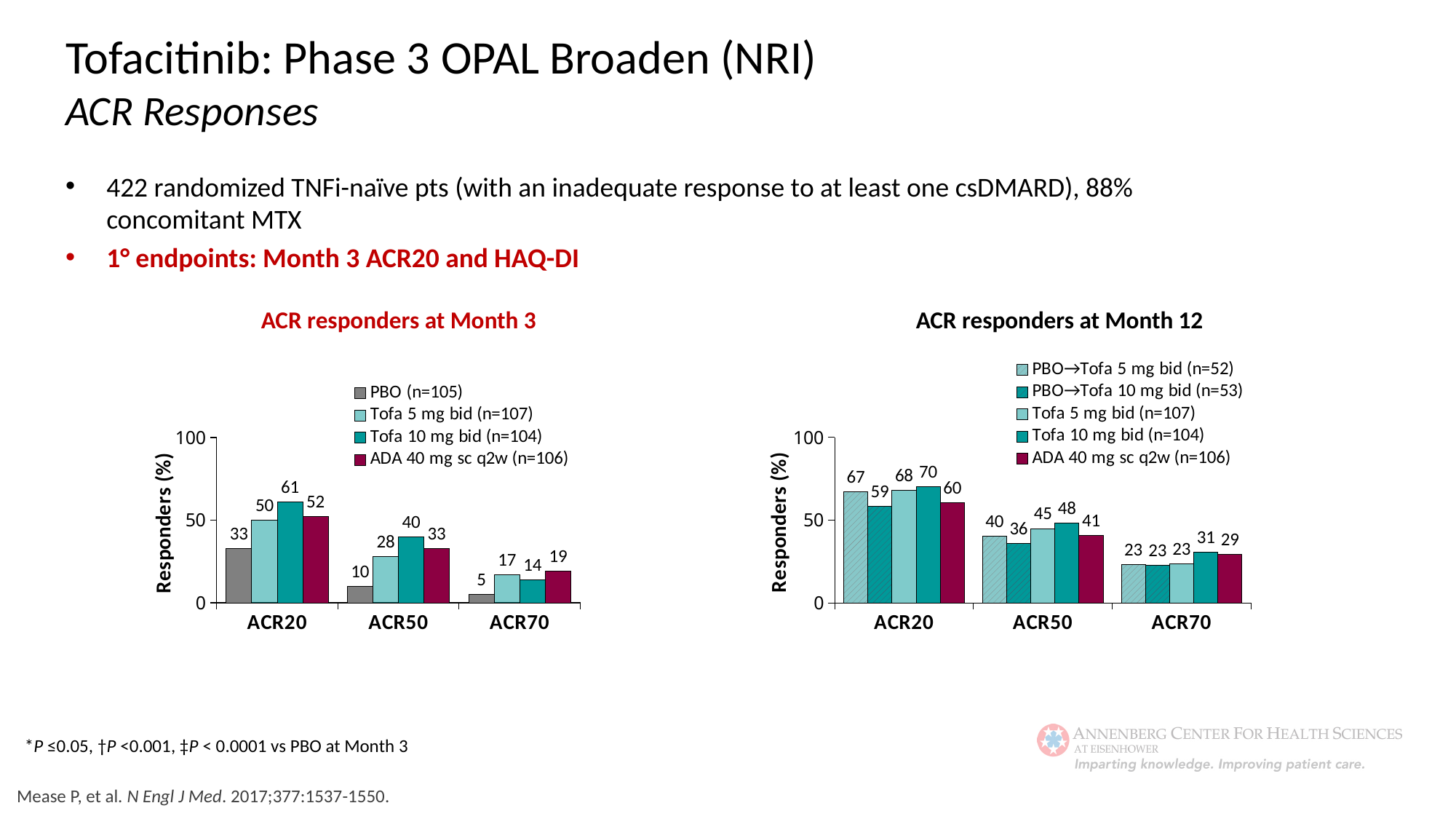
In the 'ACR responders at Month 12' chart, what is the ACR50 response for PBO→Tofa 10 mg bid (n=53)? 36 How many categories are shown on the x axis of the 'ACR responders at Month 3' chart? 3 In the 'ACR responders at Month 3' chart, which series has the highest ACR50 response? Tofa 10 mg bid (n=104) In the 'ACR responders at Month 3' chart, what is the difference between the ACR20 responses for Tofa 10 mg bid (n=104) and PBO (n=105)? 28 In the 'ACR responders at Month 3' chart, do the values for Tofa 5 mg bid (n=107) rise or fall from ACR20 to ACR70? Fall In the 'ACR responders at Month 3' chart, what is the ACR70 response for PBO (n=105)? 5 In the 'ACR responders at Month 12' chart, which series has the lowest ACR20 response? PBO→Tofa 10 mg bid (n=53) In the 'ACR responders at Month 12' chart, which is larger for ACR70: Tofa 10 mg bid (n=104) or ADA 40 mg sc q2w (n=106)? Tofa 10 mg bid (n=104) What kind of chart is the 'ACR responders at Month 12' chart? Bar chart In the 'ACR responders at Month 3' chart, is the ACR20 value for ADA 40 mg sc q2w (n=106) greater or less than 50? greater In the 'ACR responders at Month 3' chart, what is the ACR20 response for Tofa 10 mg bid (n=104)? 61 How many series does the legend of the 'ACR responders at Month 12' chart list? 5